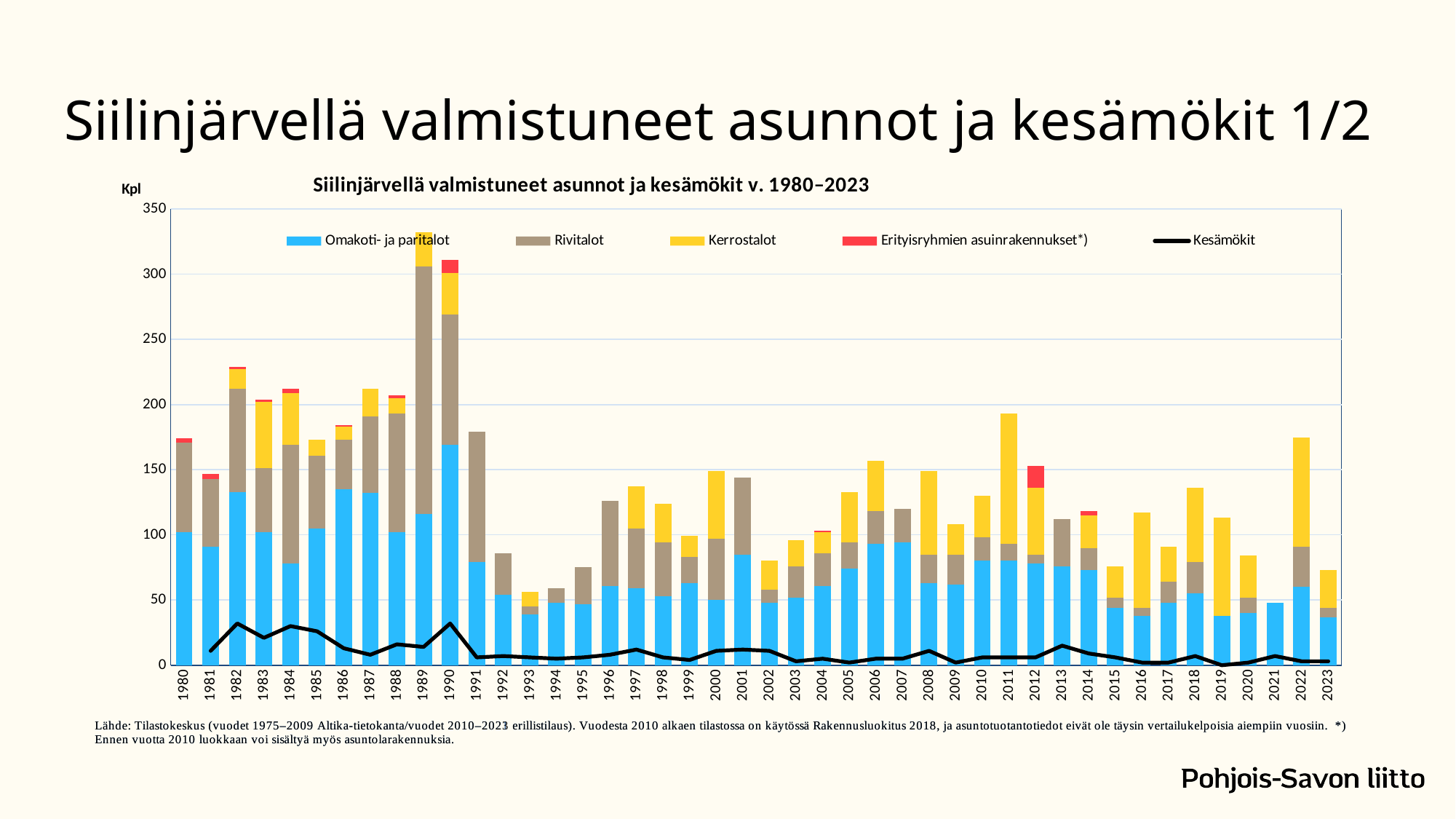
Is the total bar for 1992 greater or less than 100? less How many years are shown along the x axis of the chart? 44 Which year has the highest total bar in the chart? 1989 Which year has the larger total bar, 2022 or 2023? 2022 What kind of chart is shown on the slide? combination bar and line chart How many series does the chart legend list? 5 Is the total bar for 2011 greater or less than 150? greater Is the total bar for 2022 greater or less than 150? greater What is the title of the chart? Siilinjärvellä valmistuneet asunnot ja kesämökit v. 1980–2023 Does the Kesämökit line rise or fall from 1990 to 1991? fall Which year has the larger total bar, 1982 or 1983? 1982